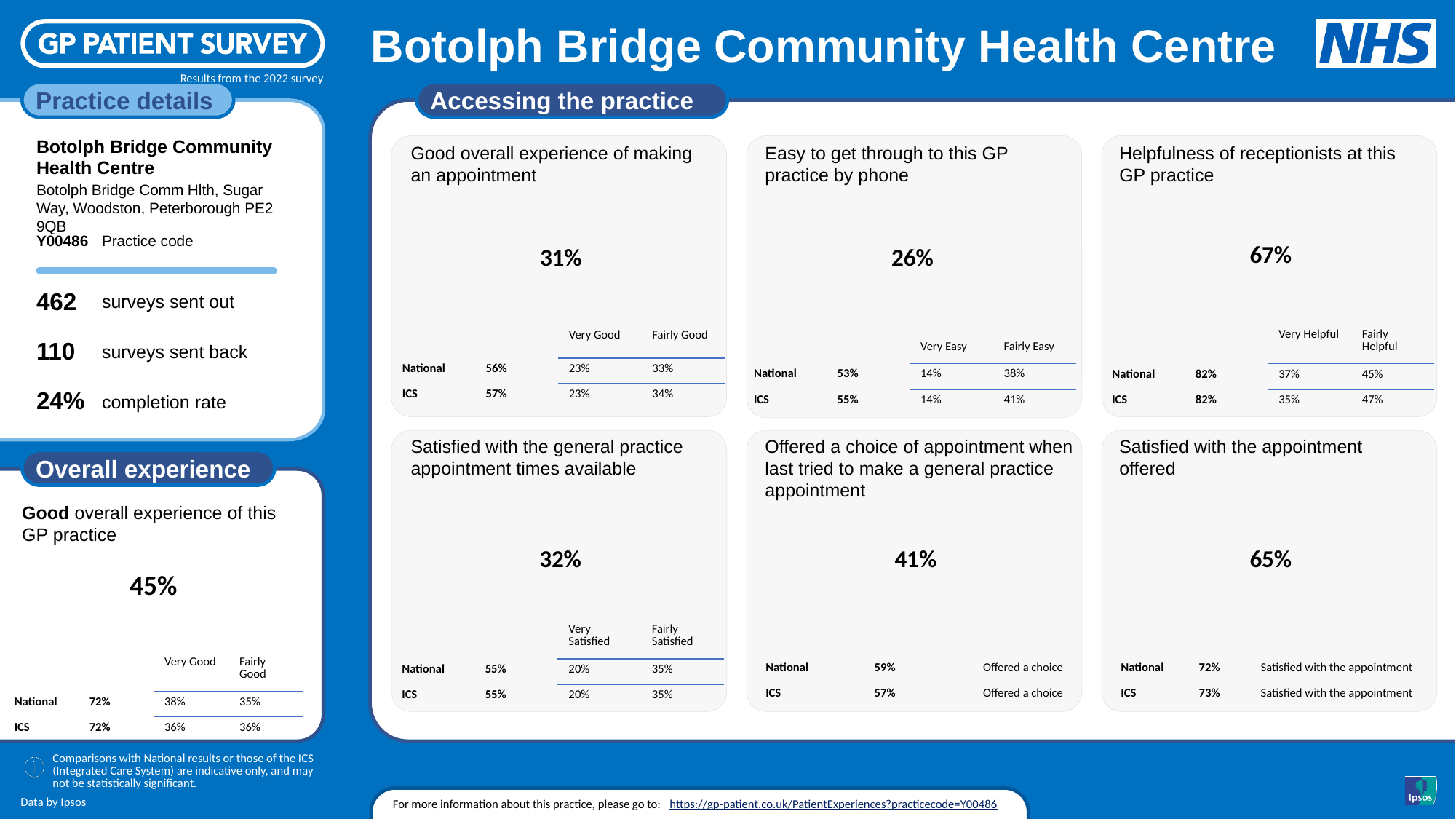
In the 'Helpfulness of receptionists at this GP practice' panel, what is the National percentage? 82% In the 'Good overall experience of making an appointment' panel, what is the practice's headline percentage? 31% Among the six 'Accessing the practice' panels, which has the highest practice headline percentage? Helpfulness of receptionists at this GP practice In the 'Offered a choice of appointment when last tried to make a general practice appointment' panel, what is the practice's headline percentage? 41% In the 'Good overall experience of making an appointment' panel, what is the difference between the National percentage (56%) and the practice's headline percentage (31%)? 25% In the 'Satisfied with the general practice appointment times available' panel, what is the practice's headline percentage? 32% In the 'Easy to get through to this GP practice by phone' panel, what is the practice's headline percentage? 26% In the 'Satisfied with the appointment offered' panel, what is the practice's headline percentage? 65% In the 'Easy to get through to this GP practice by phone' panel, what is the ICS 'Fairly Easy' percentage? 41% In the 'Helpfulness of receptionists at this GP practice' panel, what is the practice's headline percentage? 67% In the 'Good overall experience of this GP practice' panel under Overall experience, what is the practice's headline percentage? 45% In the 'Satisfied with the appointment offered' panel, which is larger: the National percentage or the ICS percentage? ICS